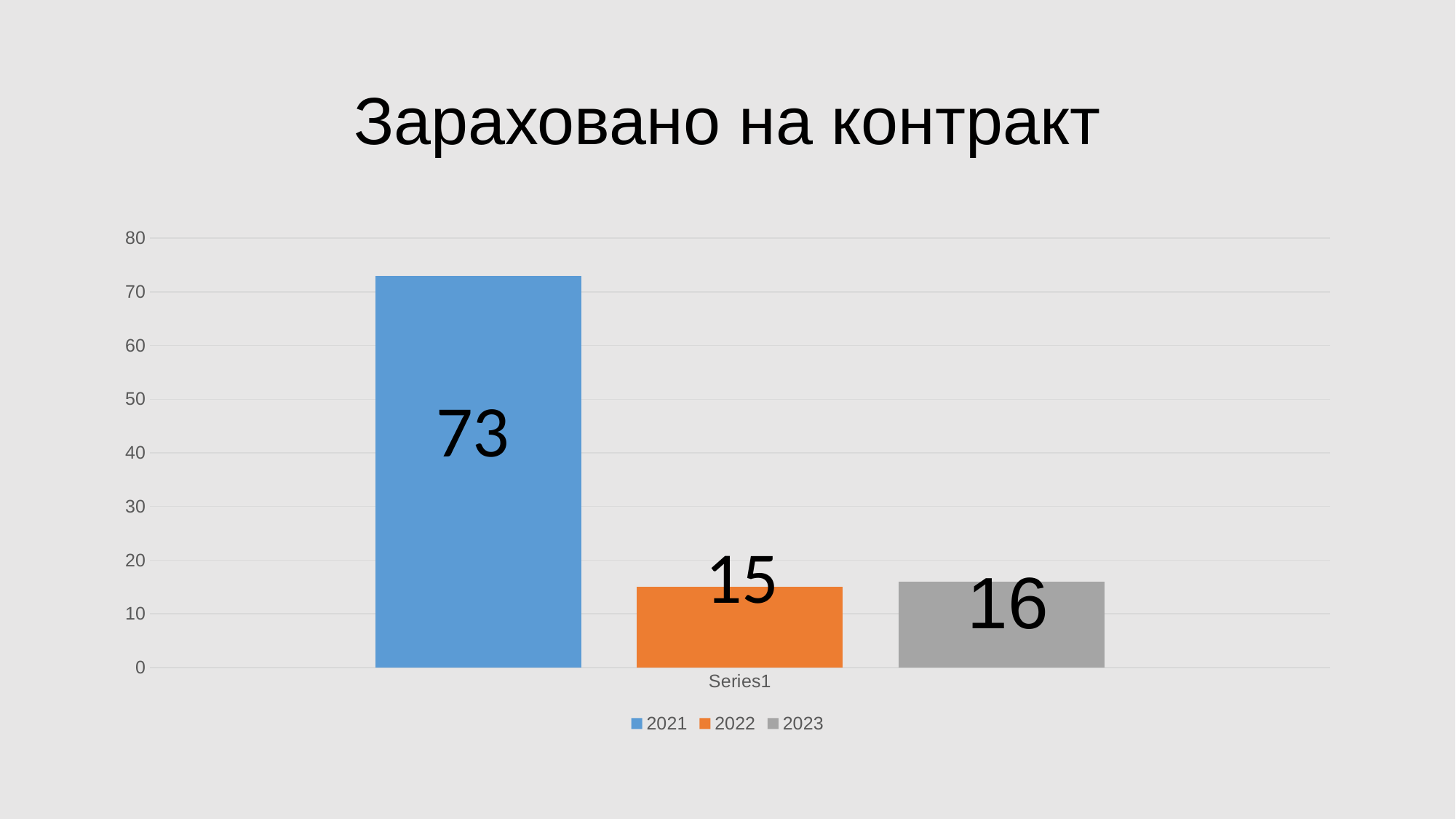
Which is larger, the value for 2021 or the value for 2022? 2021 What kind of chart is shown on the slide? bar chart What is the value for 2022? 15 What is the title of the chart? Зараховано на контракт What is the value for 2021? 73 How many series does the legend list? 3 What is the difference between the values for 2023 and 2022? 1 Is the value for 2021 greater or less than 70? greater What is the difference between the values for 2021 and 2023? 57 Which year has the lowest value? 2022 Which year has the highest value? 2021 What is the value for 2023? 16